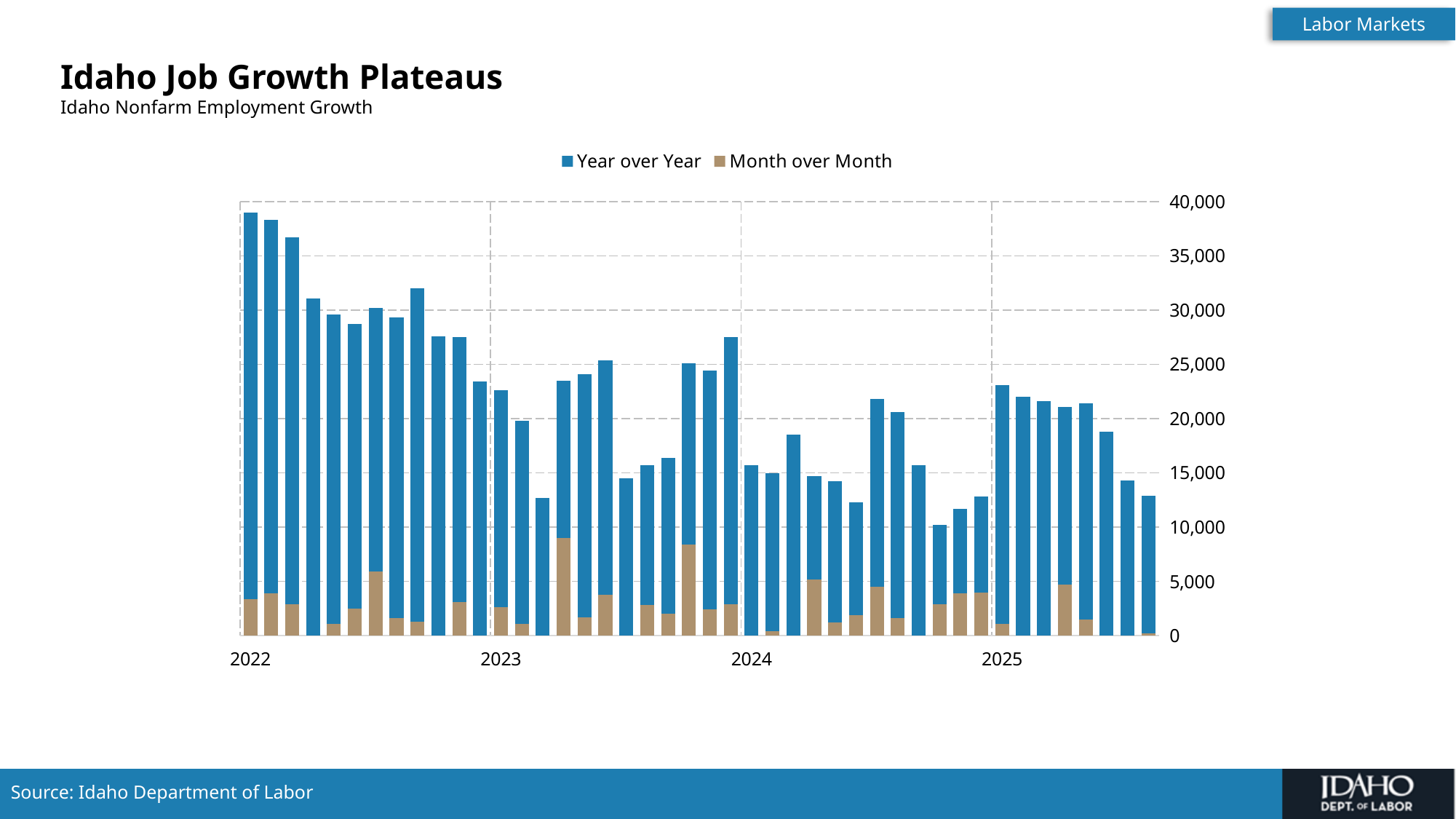
Is the Month over Month value for the first bar of 2023 greater or less than 5,000? less In which year does the tallest Year over Year bar appear? 2022 Is the Year over Year value for the first bar of 2022 greater or less than 35,000? greater How many series does the legend list? 2 What is the title of the chart? Idaho Nonfarm Employment Growth Do the Year over Year values generally rise or fall from 2022 to 2025? fall Is the Year over Year value for the first bar of 2025 greater or less than 20,000? greater What kind of chart is shown on the slide? bar chart Which series is shown in blue? Year over Year